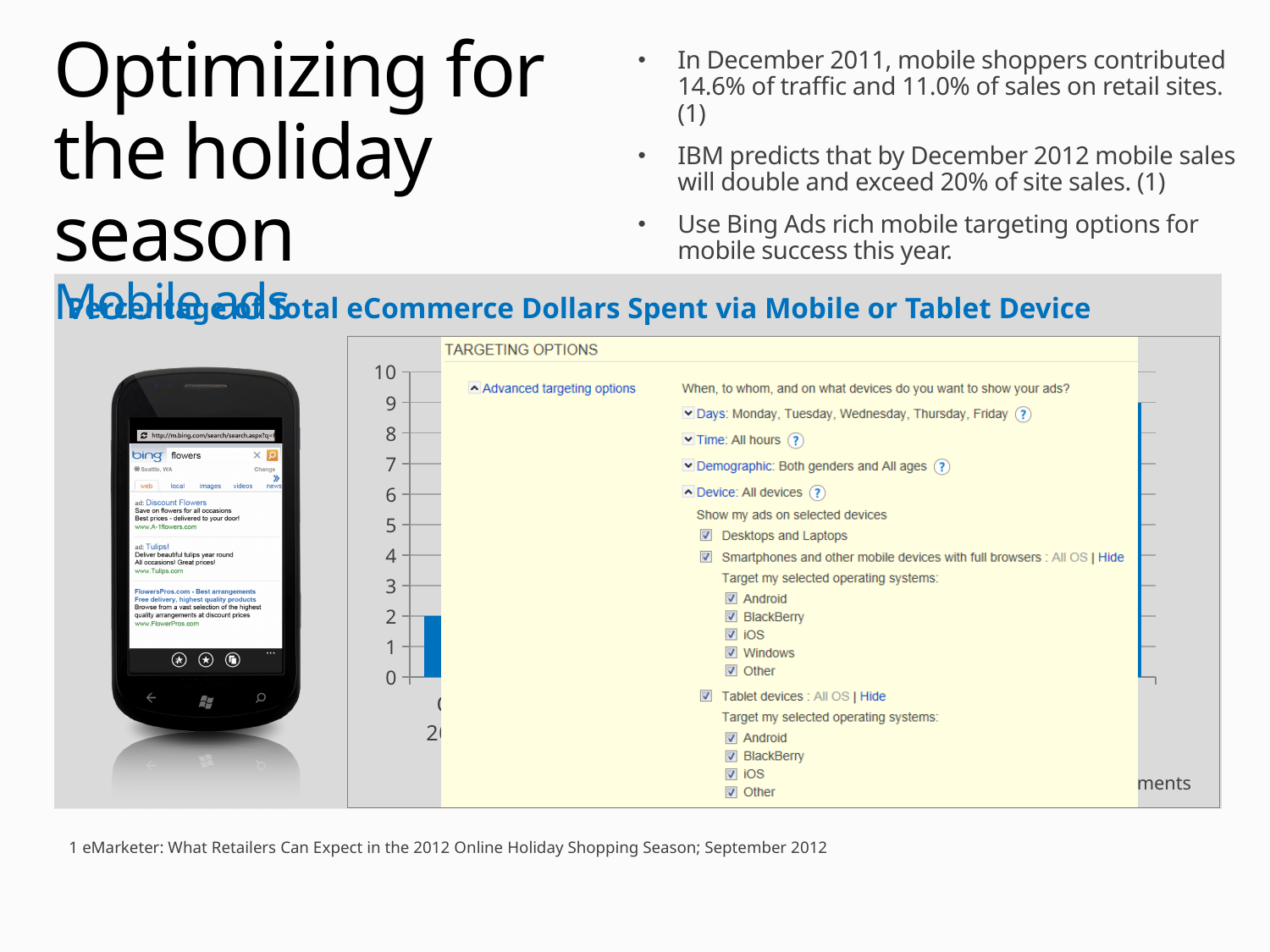
What is the highest value shown on the chart's vertical axis? 10 Is the value of the leftmost bar in the chart greater or less than 1? greater What kind of chart is shown on the slide? bar chart What is the title of the chart on the slide? Percentage of Total eCommerce Dollars Spent via Mobile or Tablet Device Is the value of the leftmost bar in the chart greater or less than 5? less